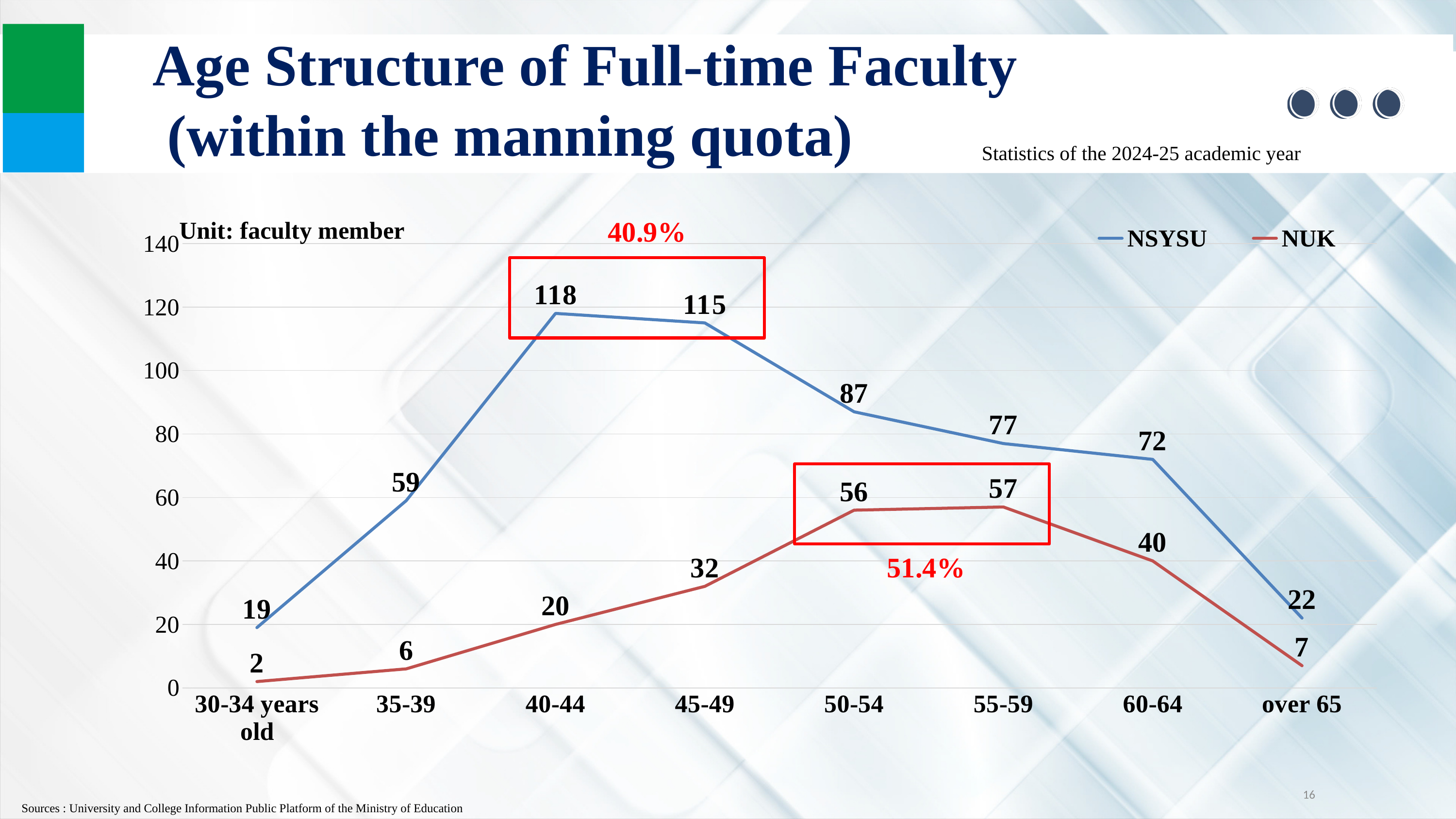
What is the difference between the NSYSU and NUK values for the 50-54 age group? 31 What unit is stated for the chart values? faculty member What is the NSYSU value for the 40-44 age group? 118 What kind of chart is shown on the slide? Line chart What is the NSYSU value for the over 65 age group? 22 Which age group has the highest NUK value? 55-59 How many age groups are shown on the x axis? 8 How many series does the legend list? 2 Does the NUK line rise or fall from 30-34 years old to 55-59? Rise What is the NUK value for the 55-59 age group? 57 Which is larger, the NSYSU value for 35-39 or the NUK value for 55-59? NSYSU value for 35-39 Which age group has the lowest NSYSU value? 30-34 years old